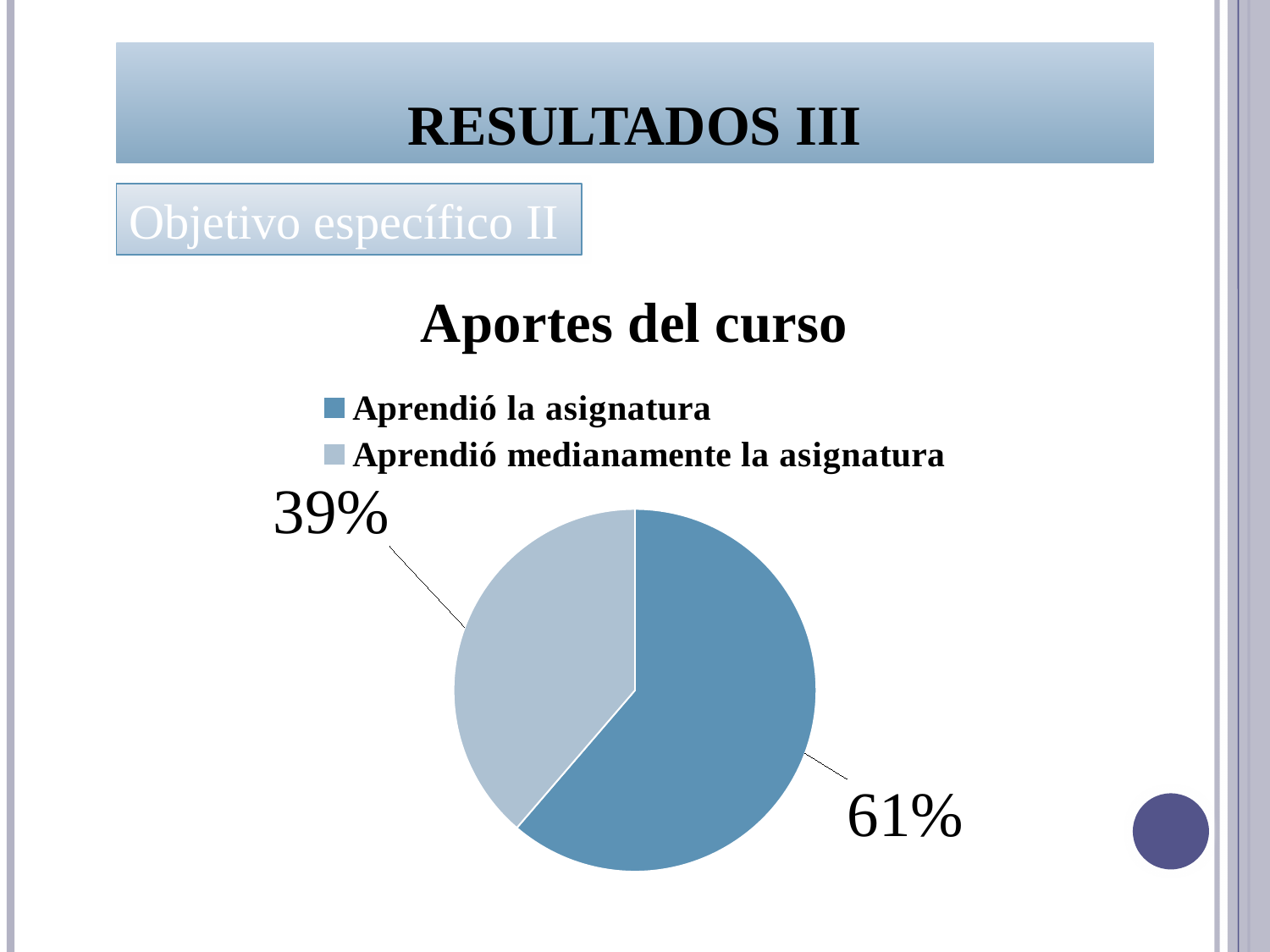
Which category has the largest slice of the pie? Aprendió la asignatura What kind of chart is shown on the slide? pie chart How many slices does the pie chart have? 2 How many entries does the legend list? 2 Which category has the smallest slice of the pie? Aprendió medianamente la asignatura What share of the pie is labelled "Aprendió medianamente la asignatura"? 39% What is the title of the chart? Aportes del curso What is the difference in percentage points between the "Aprendió la asignatura" slice and the "Aprendió medianamente la asignatura" slice? 22 Which is larger: the slice for "Aprendió la asignatura" or the slice for "Aprendió medianamente la asignatura"? Aprendió la asignatura What share of the pie is labelled "Aprendió la asignatura"? 61% Is the share for "Aprendió la asignatura" greater or less than 50%? greater Which legend entry is shown in the lighter blue colour? Aprendió medianamente la asignatura